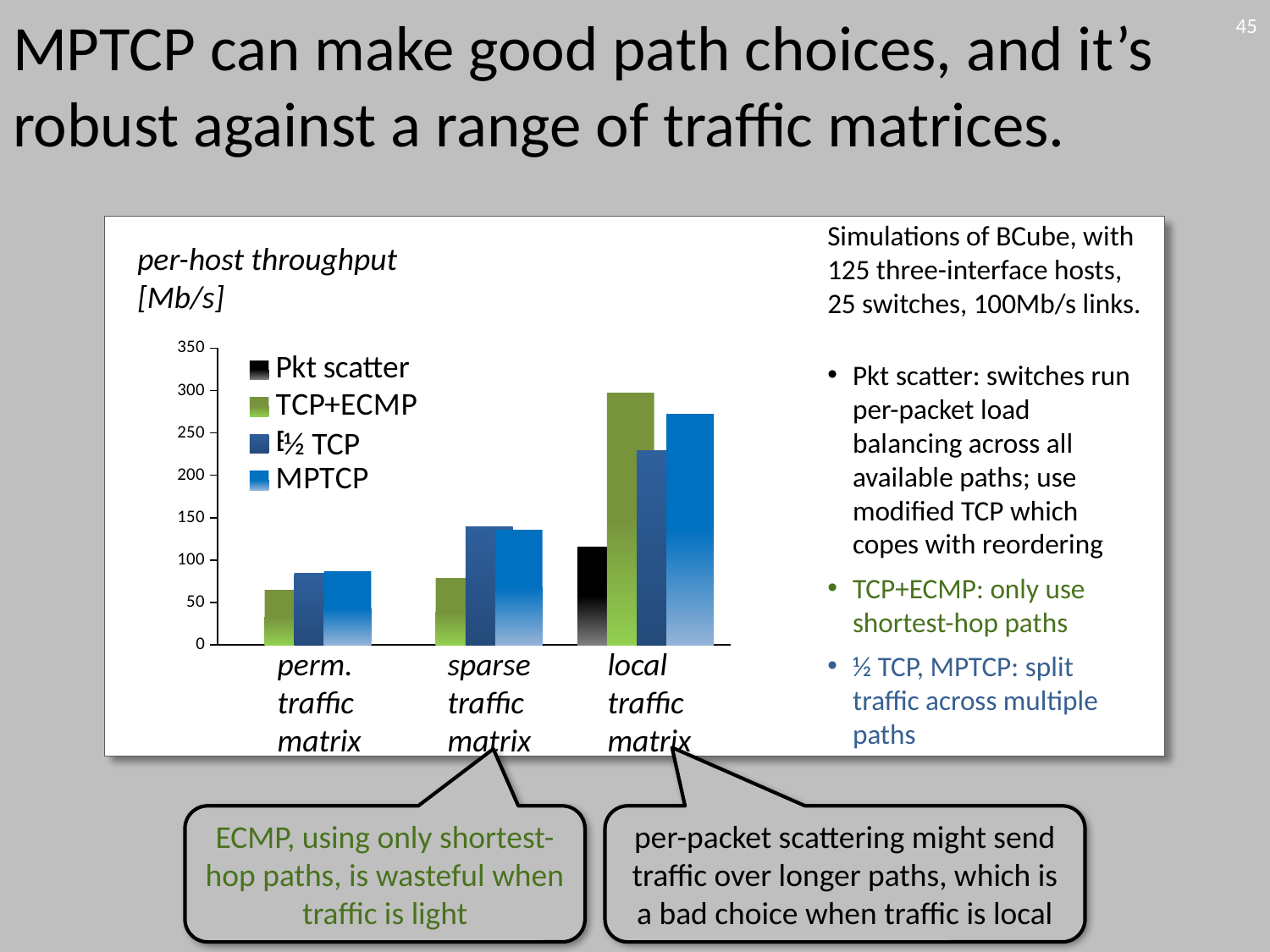
Which series has the lowest per-host throughput for the local traffic matrix? Pkt scatter What kind of chart is shown on the slide? bar chart Is the ½ TCP value for the local traffic matrix greater or less than 250? less Is the TCP+ECMP value for the local traffic matrix greater or less than 250? greater What quantity and unit does the chart plot, according to its axis label? per-host throughput [Mb/s] Is the TCP+ECMP value for the perm. traffic matrix greater or less than 100? less Does the TCP+ECMP per-host throughput rise or fall going from the perm. traffic matrix to the local traffic matrix? rise How many series does the chart's legend list? 4 How many traffic matrix categories are shown on the x axis of the chart? 3 Which series has the highest per-host throughput for the local traffic matrix? TCP+ECMP For the sparse traffic matrix, which is larger: the TCP+ECMP value or the MPTCP value? MPTCP